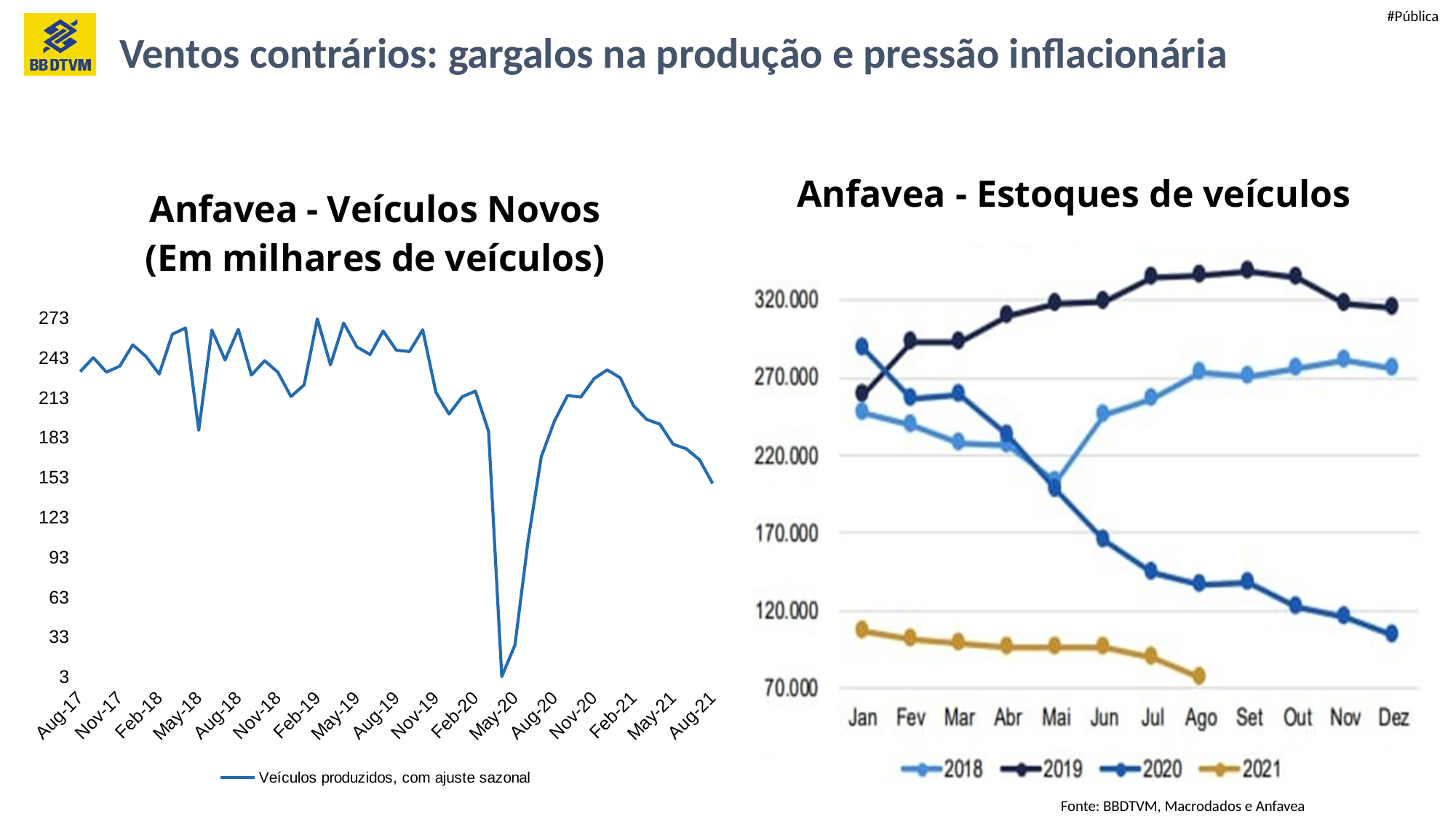
In the 'Anfavea - Estoques de veículos' chart, is the 2021 value for Ago greater or less than 120.000? less How many months are shown on the x axis of the 'Anfavea - Estoques de veículos' chart? 12 In the 'Anfavea - Veículos Novos' chart, is the value for Aug-17 greater or less than 213? greater In the 'Anfavea - Estoques de veículos' chart, do the 2020 values rise or fall from Jan to Dez? fall In the 'Anfavea - Estoques de veículos' chart, which is larger in Dez: the 2019 value or the 2020 value? 2019 In the 'Anfavea - Estoques de veículos' chart, is the 2019 value for Set greater or less than 320.000? greater In the 'Anfavea - Veículos Novos' chart, do the values rise or fall from Feb-21 to Aug-21? fall What kind of chart is the 'Anfavea - Veículos Novos' chart on the left? line chart In the 'Anfavea - Estoques de veículos' chart, in which month is the 2020 series lowest? Dez How many series does the legend of the 'Anfavea - Estoques de veículos' chart list? 4 In the 'Anfavea - Estoques de veículos' chart, which series has the lowest value in Jan? 2021